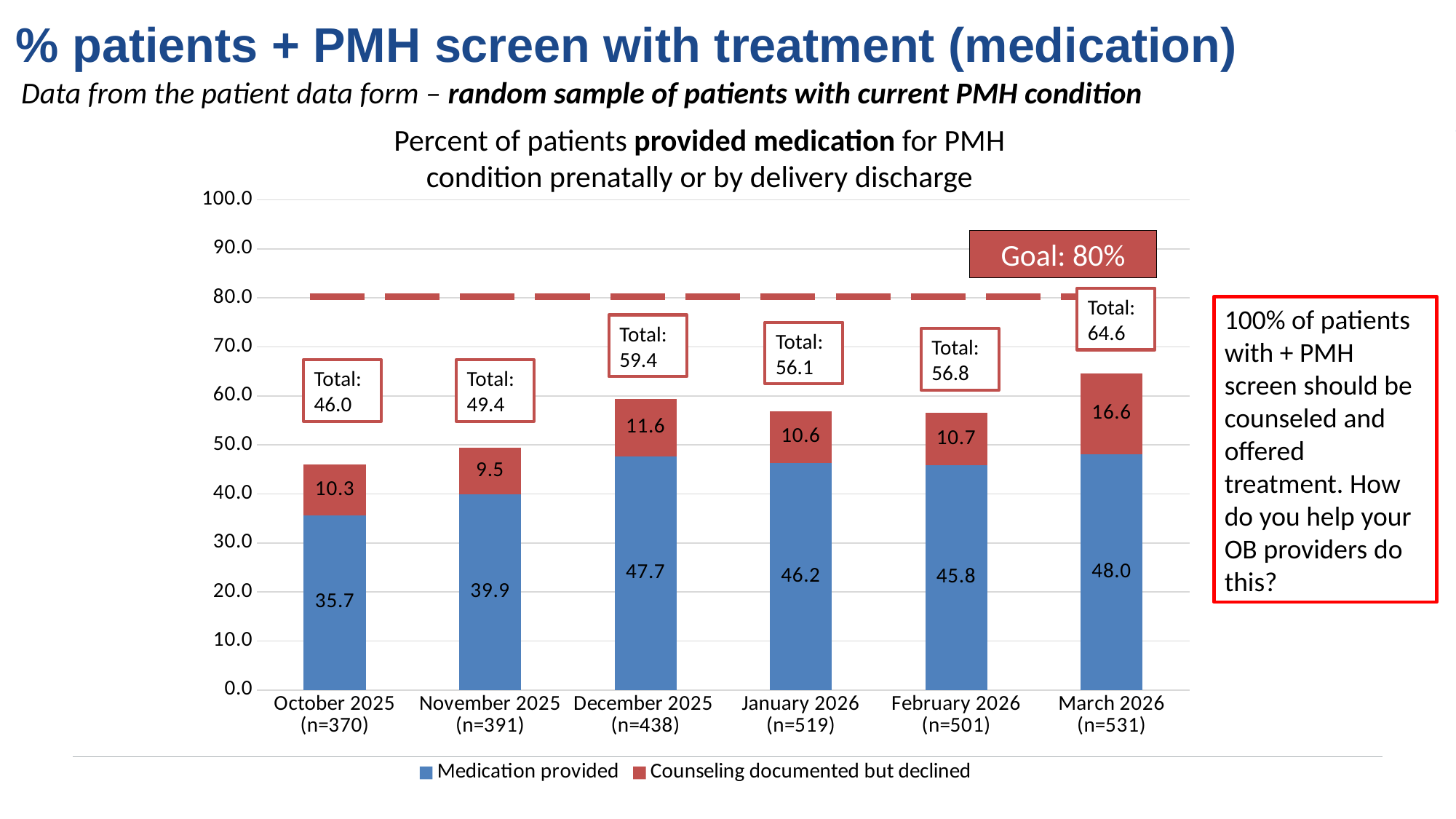
What kind of chart is shown? Stacked bar chart How many months are shown on the x axis? 6 Which month has the highest Medication provided value? March 2026 Which is larger, the Medication provided value for January 2026 or for February 2026? January 2026 Is the total for March 2026 greater or less than 80? less How many series does the legend list? 2 Which month has the lowest Counseling documented but declined value? November 2025 What goal value is marked by the dashed line? 80% What is the value for Medication provided in October 2025? 35.7 What is the value for Counseling documented but declined in March 2026? 16.6 What is the difference between the Medication provided values for December 2025 and October 2025? 12.0 What is the total of the stacked bar for December 2025? 59.4